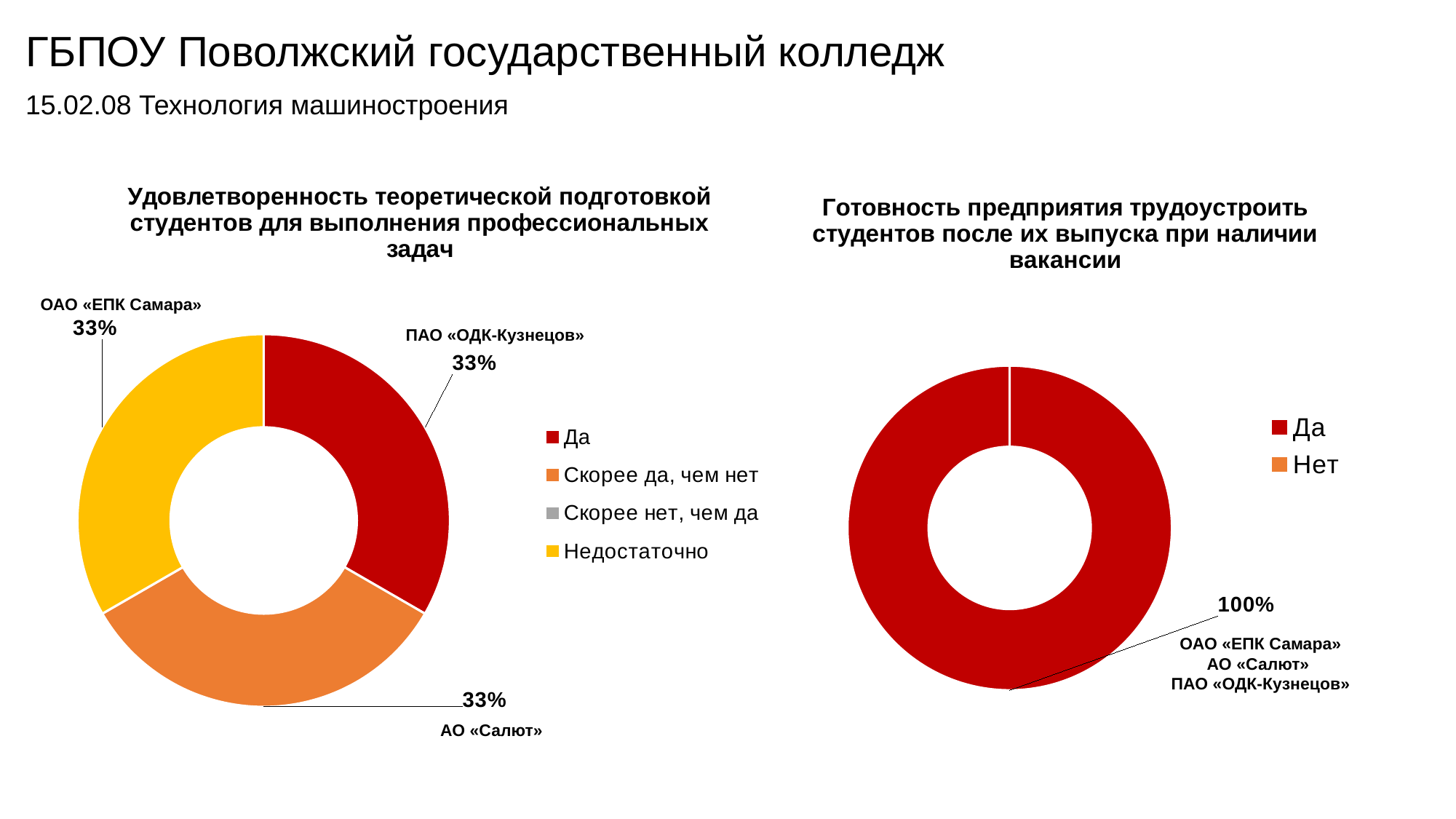
In the left chart, which legend category does the yellow slice (ОАО «ЕПК Самара») correspond to? Недостаточно In the left chart, which legend category does the red slice (ПАО «ОДК-Кузнецов») correspond to? Да In the left chart, what share is labelled for ОАО «ЕПК Самара»? 33% How many entries does the legend of the right chart list? 2 In the right chart, what percentage is shown for the 'Да' slice? 100% In the left chart, what share is labelled for АО «Салют»? 33% What kind of chart is the right chart, 'Готовность предприятия трудоустроить студентов после их выпуска при наличии вакансии'? Doughnut (pie) chart In the right chart, which enterprises are listed next to the 100% label? ОАО «ЕПК Самара», АО «Салют», ПАО «ОДК-Кузнецов» What kind of chart is the left chart, 'Удовлетворенность теоретической подготовкой студентов для выполнения профессиональных задач'? Doughnut (pie) chart How many entries does the legend of the left chart list? 4 In the left chart, what share is labelled for ПАО «ОДК-Кузнецов»? 33% How many slices does the left chart have? 3